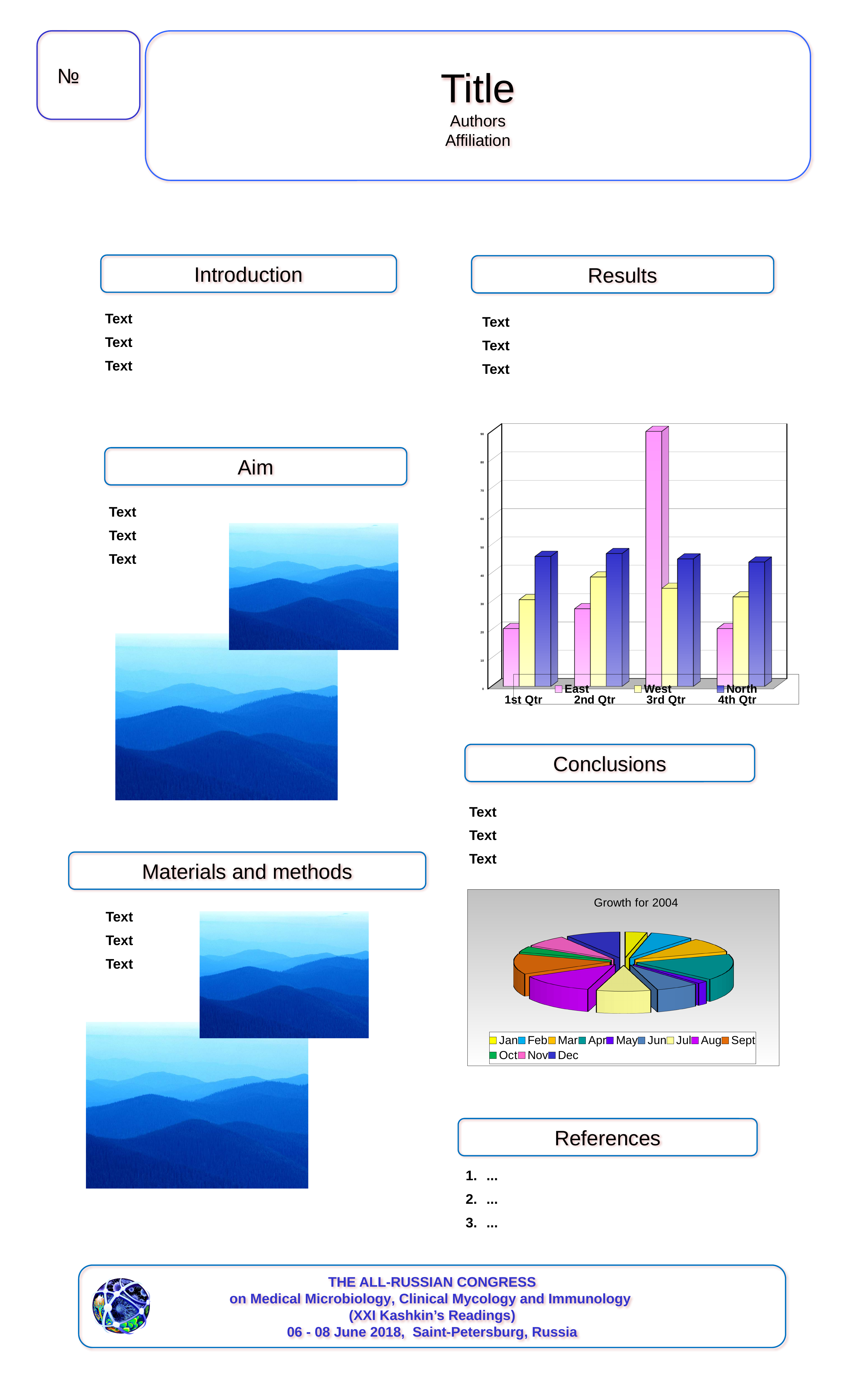
In the bar chart in the Results section, how many series does the legend list? 3 How many entries does the legend of the pie chart in the Conclusions section list? 12 What kind of chart is shown in the Conclusions section? pie chart In the bar chart in the Results section, how many quarter categories are shown on the x axis? 4 In the bar chart in the Results section, is the value for North in 1st Qtr greater or less than 40? greater In the bar chart in the Results section, which is larger in 4th Qtr, East or North? North In the bar chart in the Results section, is the value for East in 3rd Qtr greater or less than 80? greater What kind of chart is shown in the Results section? bar chart What is the title of the pie chart in the Conclusions section? Growth for 2004 In the bar chart in the Results section, is the value for East in 1st Qtr greater or less than 30? less In the bar chart in the Results section, in which quarter is the East series highest? 3rd Qtr In the bar chart in the Results section, which is larger in 1st Qtr, East or West? West